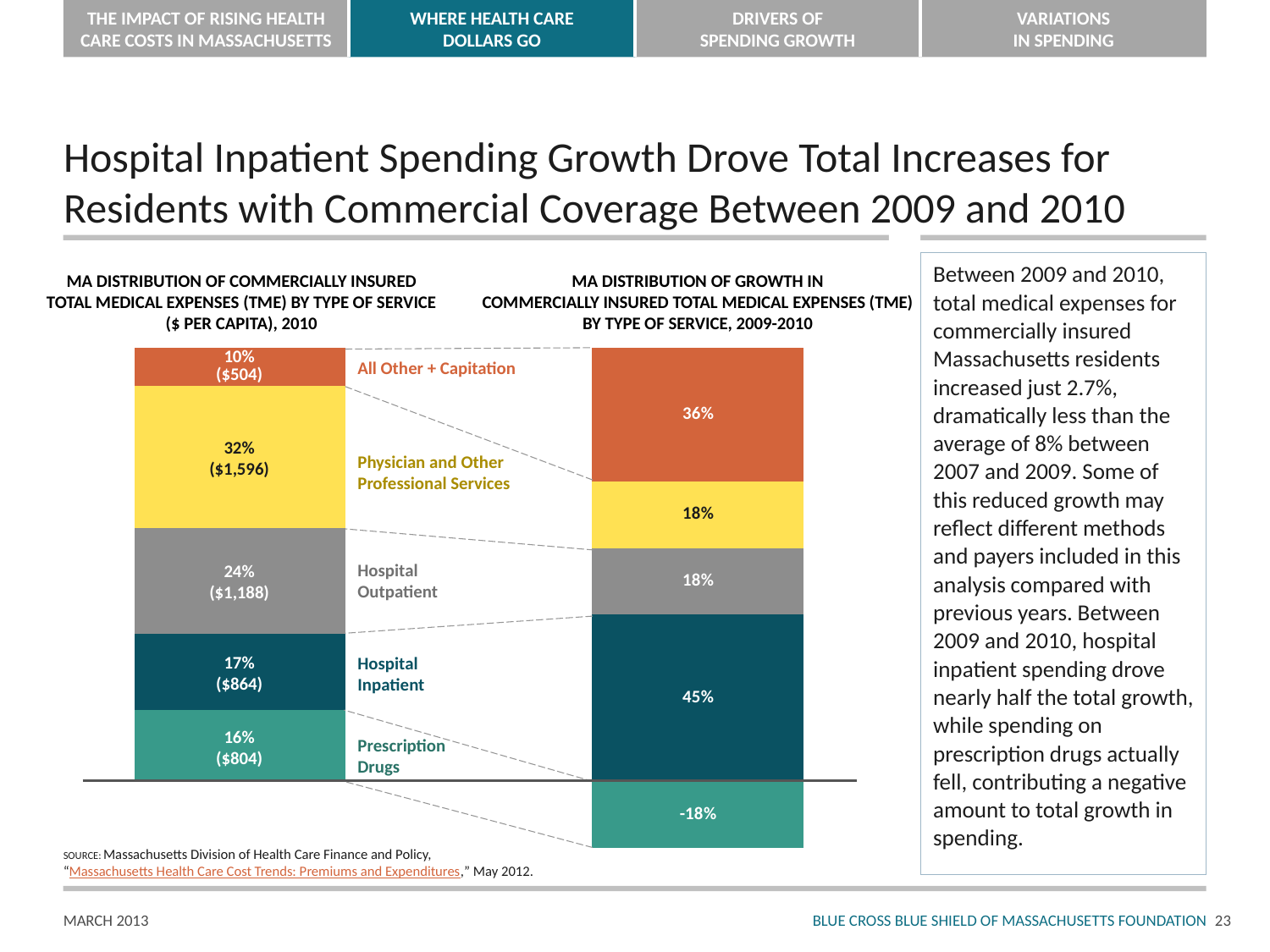
In the left chart (MA distribution of commercially insured TME, 2010), which type of service has the largest share? Physician and Other Professional Services In the left chart (MA distribution of commercially insured TME, 2010), which type of service has the smallest share? All Other + Capitation In the left chart (MA distribution of commercially insured TME by type of service, 2010), what share of spending is Physician and Other Professional Services? 32% In the left chart (MA distribution of commercially insured TME, 2010), what is the difference in per-capita dollars between Hospital Inpatient and Prescription Drugs? $60 In the right chart (MA distribution of growth in commercially insured TME, 2009-2010), what share of growth is attributed to Hospital Inpatient? 45% What kind of chart is used on this slide to show the distribution of medical expenses? Stacked bar chart How many types of service are shown in each stacked bar on the slide? 5 In the right chart (MA distribution of growth in commercially insured TME, 2009-2010), what is the difference between the Hospital Inpatient share and the All Other + Capitation share? 9 percentage points In the left chart (MA distribution of commercially insured TME, 2010), what is the per-capita dollar amount for Prescription Drugs? $804 In the right chart (MA distribution of growth in commercially insured TME, 2009-2010), which type of service contributed the largest share of growth? Hospital Inpatient In the right chart (MA distribution of growth in commercially insured TME, 2009-2010), what is the value for Prescription Drugs? -18% In the left chart (MA distribution of commercially insured TME, 2010), what is the per-capita dollar amount for Hospital Outpatient? $1,188